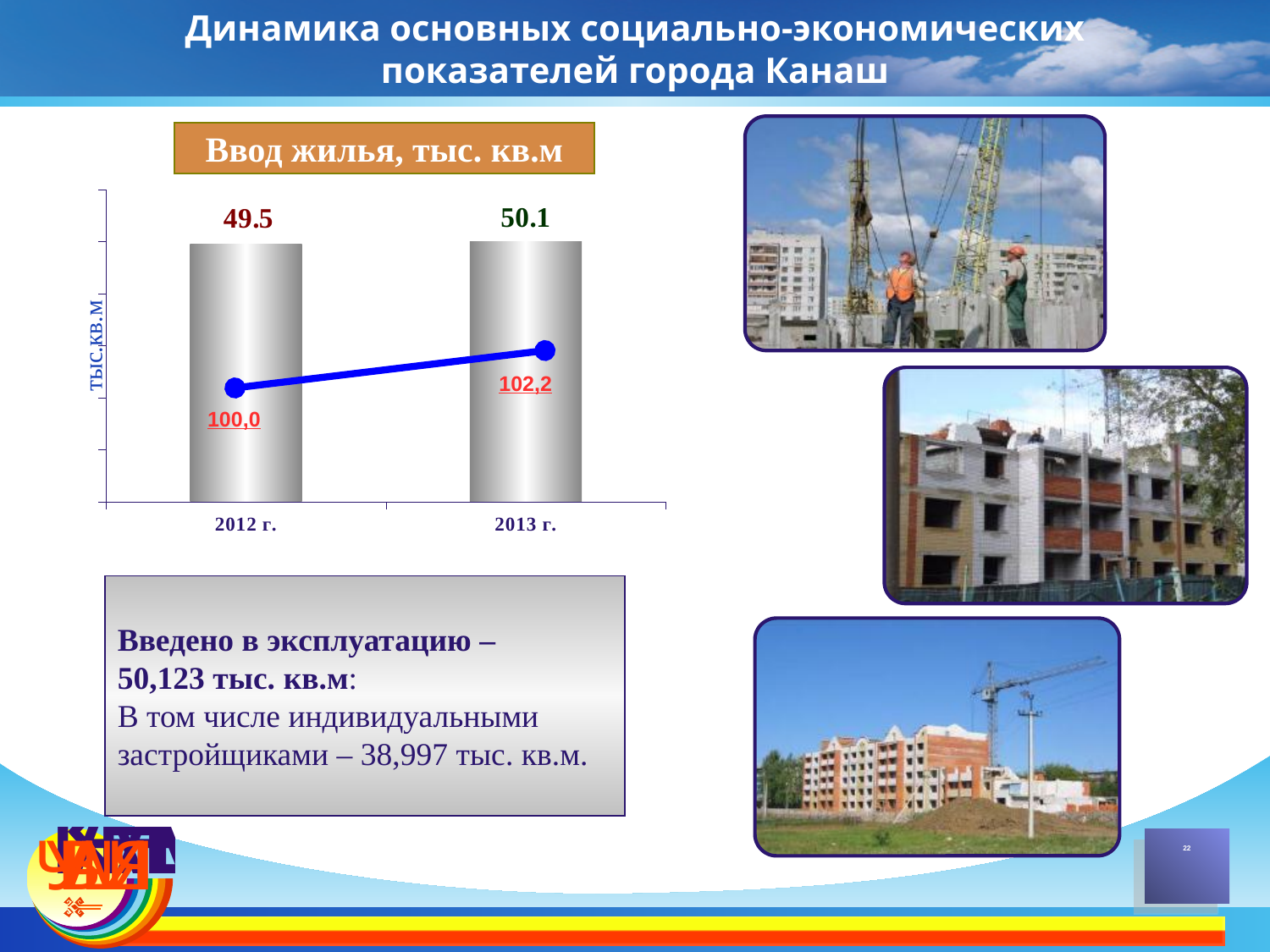
Which year has the higher bar value for housing commissioned? 2013 г. What is the value of housing commissioned (Ввод жилья) for 2012 г.? 49.5 What kind of chart is used to show housing commissioned? bar chart with a line What is the line value shown for 2012 г.? 100,0 Does the line value rise or fall from 2012 г. to 2013 г.? rise Which year has the lower bar value for housing commissioned? 2012 г. Is the bar value for 2013 г. larger or smaller than the bar value for 2012 г.? larger By how much does the bar value for 2013 г. exceed that for 2012 г.? 0.6 What is the line value shown for 2013 г.? 102,2 How many years (categories) are shown on the x axis of the chart? 2 What is the title of the chart? Ввод жилья, тыс. кв.м What is the value of housing commissioned (Ввод жилья) for 2013 г.? 50.1